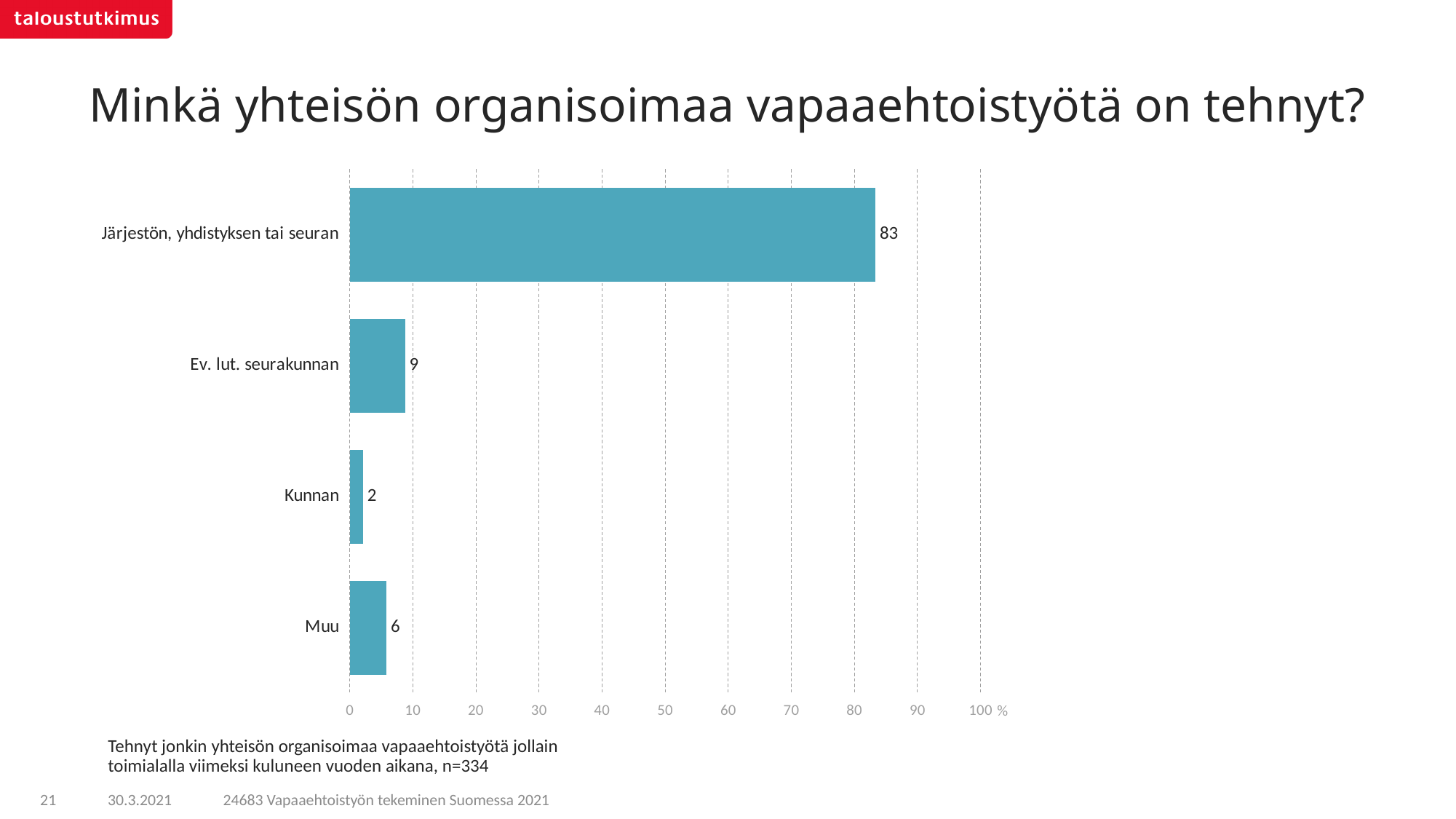
Which category has the lowest value? Kunnan What kind of chart is shown on the slide? bar chart What is the difference between the values for "Ev. lut. seurakunnan" and "Muu"? 3 Which category has the highest value? Järjestön, yhdistyksen tai seuran How many categories are shown in the chart? 4 What is the value for "Ev. lut. seurakunnan"? 9 What is the difference between the values for "Järjestön, yhdistyksen tai seuran" and "Ev. lut. seurakunnan"? 74 What is the value for "Järjestön, yhdistyksen tai seuran"? 83 Which is larger, the value for "Muu" or the value for "Kunnan"? Muu What is the value for "Kunnan"? 2 What is the value for "Muu"? 6 Is the value for "Järjestön, yhdistyksen tai seuran" greater or less than 50? greater